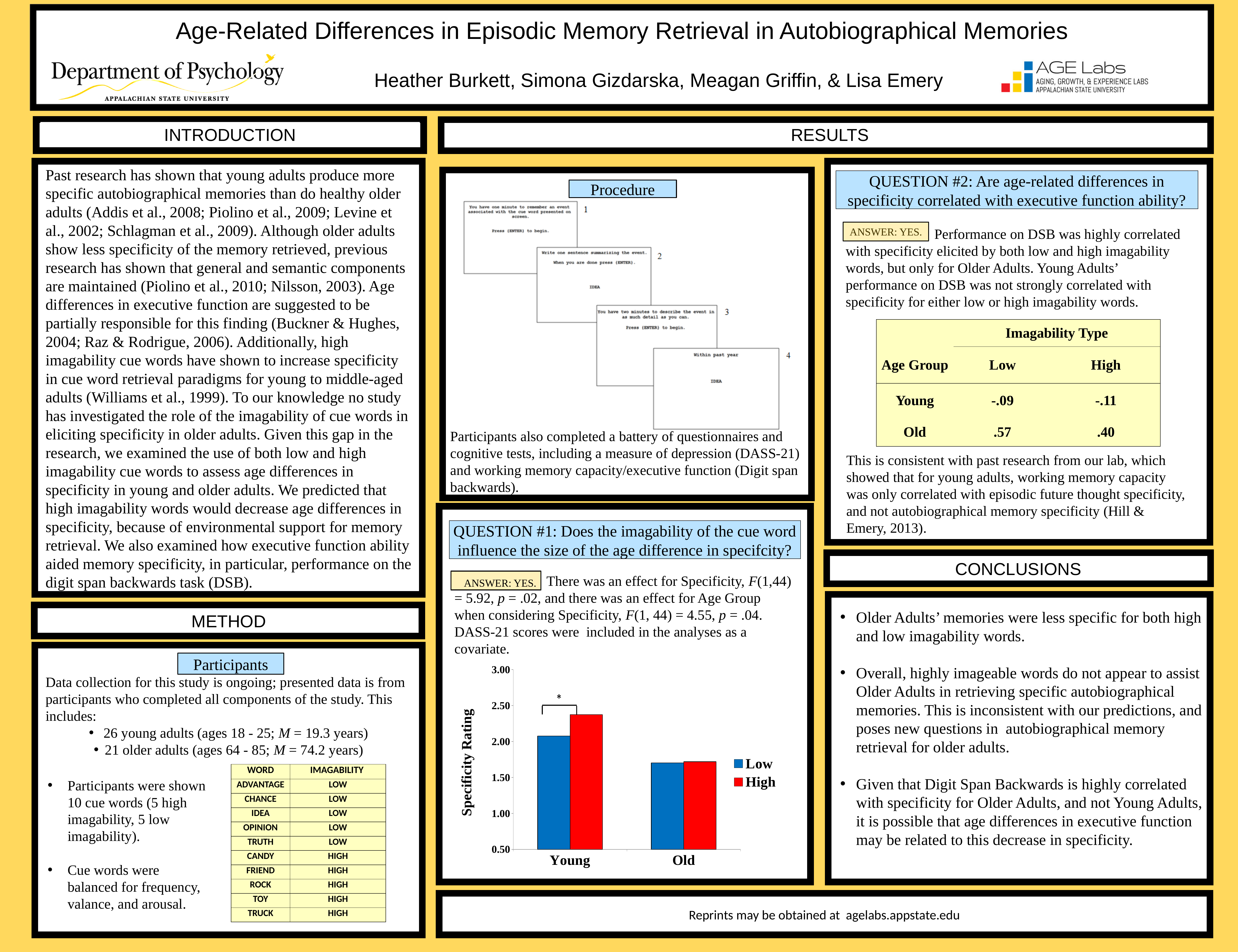
How many series does the legend of the bar chart list? 2 In the bar chart, is the Young High imagability bar greater or less than 2.00? greater Which bar in the chart is the highest? Young, High In the bar chart, is the Old High imagability bar greater or less than 1.50? greater What is the label on the y axis of the bar chart? Specificity Rating For the Young group, which bar is taller: Low or High imagability? High In the bar chart, is the Young Low imagability bar greater or less than 2.50? less What kind of chart is shown in the Question #1 results panel? bar chart How many age groups are shown on the x axis of the bar chart? 2 Does the specificity rating for the High imagability series rise or fall from Young to Old? fall Which colour represents the High imagability series in the bar chart? red